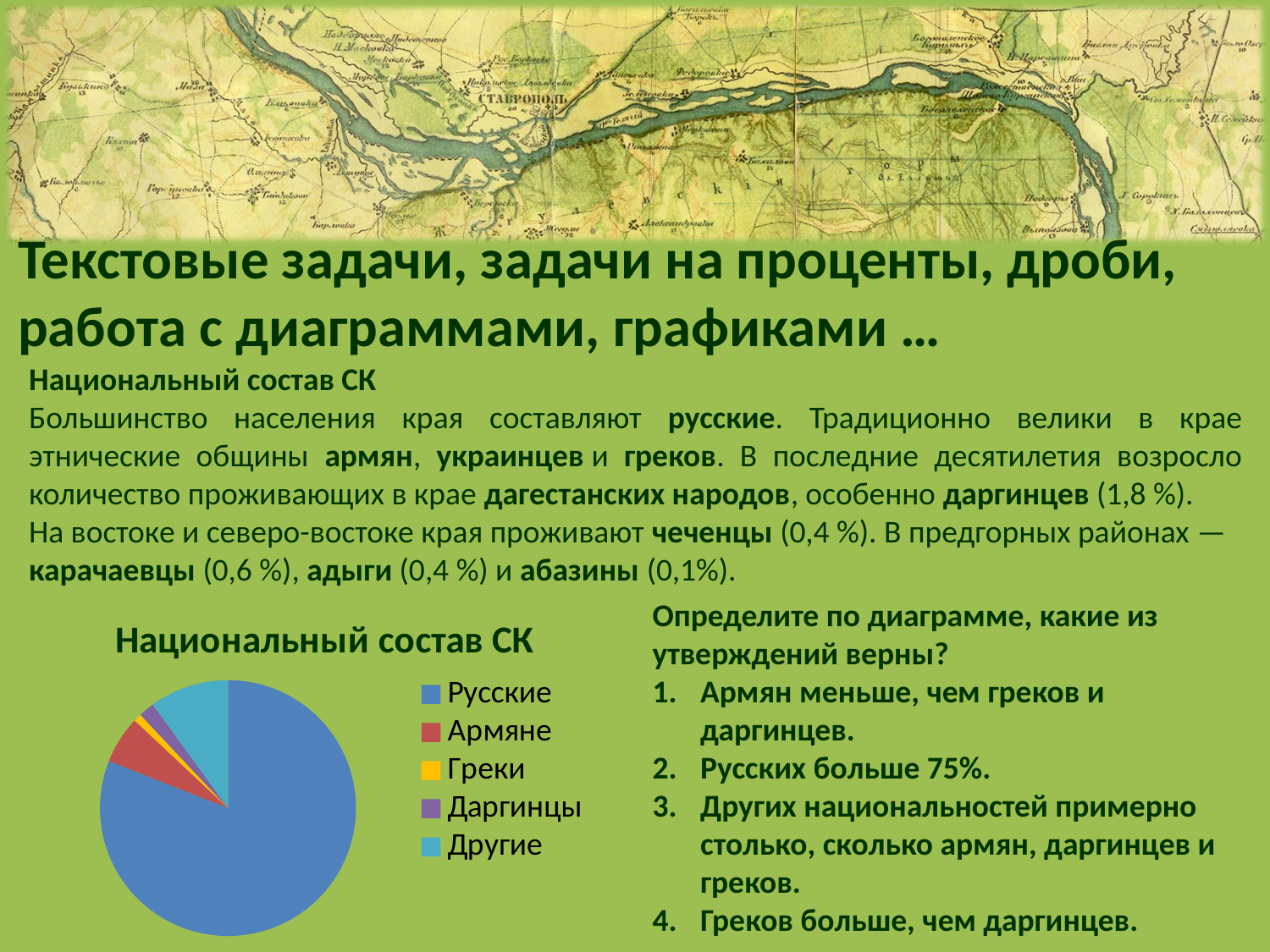
Which slice is larger in the pie chart, Армяне or Греки? Армяне Which slice is larger in the pie chart, Русские or Другие? Русские Which slice is larger in the pie chart, Русские or Армяне? Русские What colour is the Русские slice in the pie chart? blue What is the title of the pie chart? Национальный состав СК Which category has the largest slice in the pie chart? Русские How many entries does the legend of the pie chart list? 5 What kind of chart is shown on the slide? pie chart How many slices does the pie chart have? 5